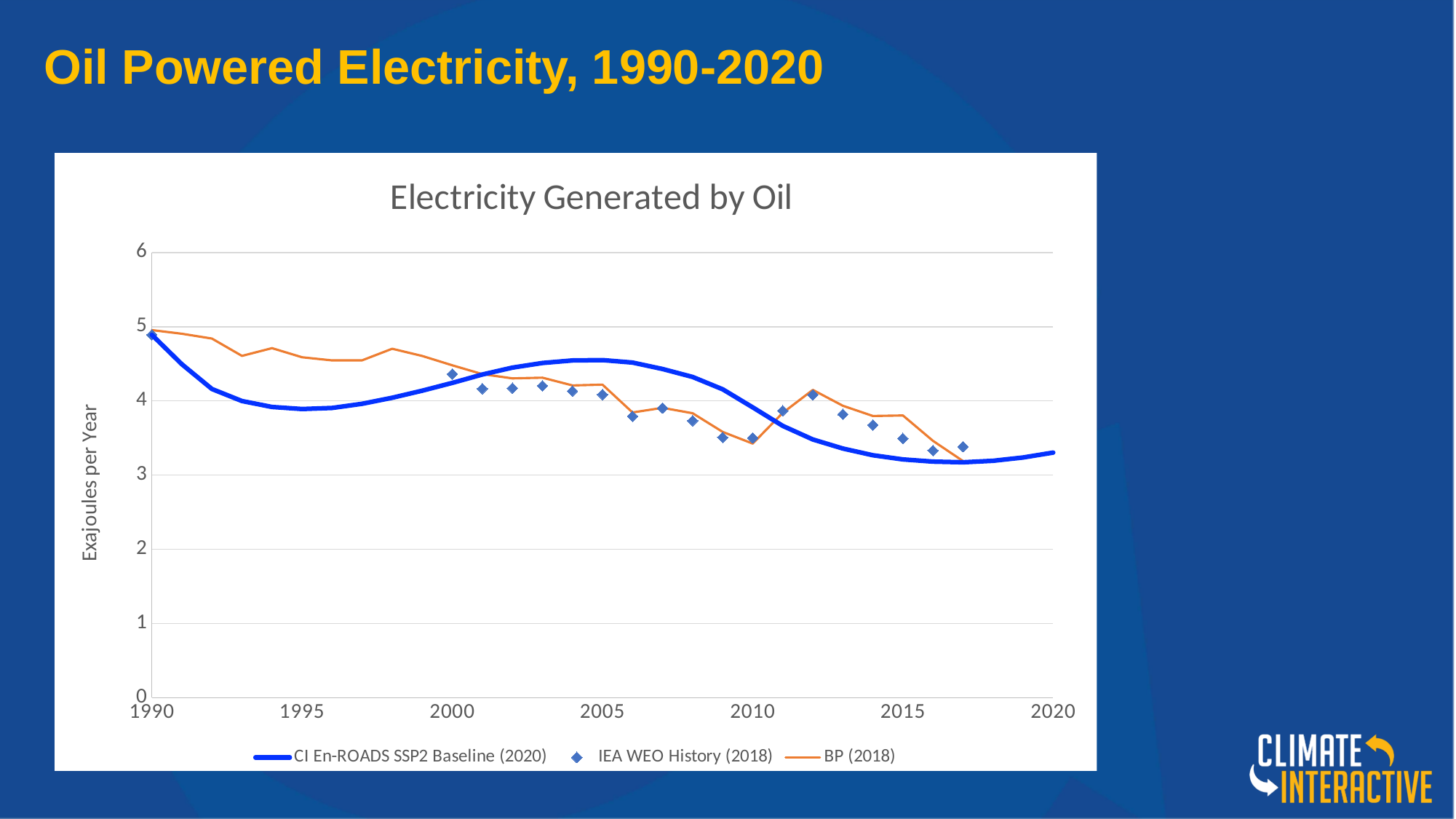
What is the label on the vertical axis? Exajoules per Year What kind of chart is shown on the slide? line chart Is the value of the CI En-ROADS SSP2 Baseline (2020) line in 2020 greater or less than 3? greater How many year labels are shown along the x axis? 7 Is the IEA WEO History (2018) value in 2017 greater or less than 4? less Between 2005 and 2017, does the CI En-ROADS SSP2 Baseline (2020) line rise or fall? fall In 1995, which series has the higher value: BP (2018) or CI En-ROADS SSP2 Baseline (2020)? BP (2018) What is the title of the chart? Electricity Generated by Oil Is the value of the CI En-ROADS SSP2 Baseline (2020) line in 1990 greater or less than 4? greater In 2005, which series has the higher value: CI En-ROADS SSP2 Baseline (2020) or IEA WEO History (2018)? CI En-ROADS SSP2 Baseline (2020) How many series does the legend list? 3